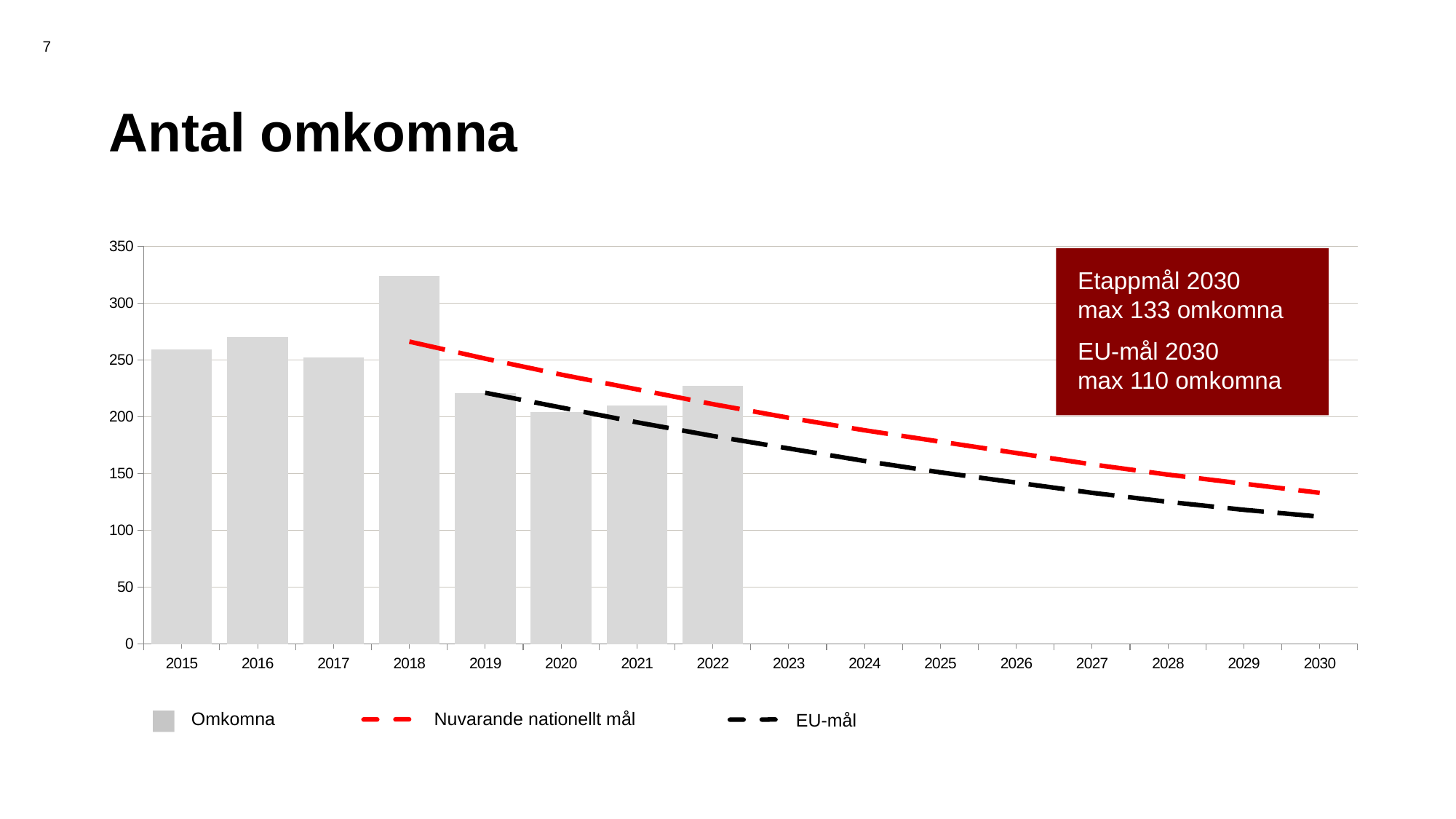
What is the title of the chart? Antal omkomna Which year has the larger Omkomna bar, 2016 or 2017? 2016 Is the Omkomna value for 2018 greater or less than 300? greater How many years are shown on the x axis? 16 Is the Omkomna value for 2016 greater or less than 250? greater Which year has the highest Omkomna bar? 2018 Does the Nuvarande nationellt mål line rise or fall from 2018 to 2030? It falls How many years have an Omkomna bar plotted? 8 How many series does the legend list? 3 Is the Omkomna value for 2022 greater or less than 250? less According to the slide, what is the EU-mål maximum number of omkomna for 2030? 110 What kind of chart is shown on the slide? A bar chart combined with dashed line series